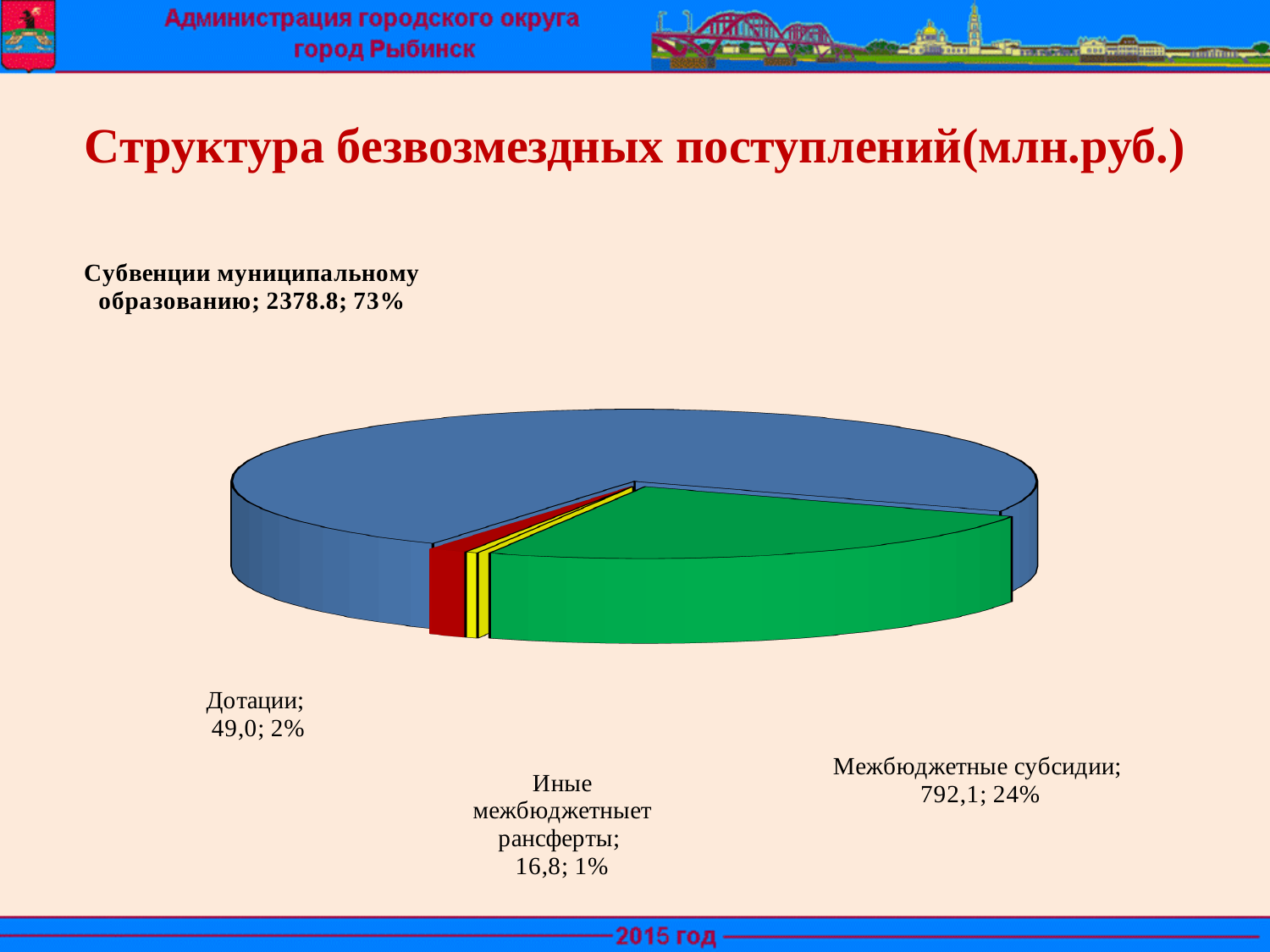
What is the value for Иные межбюджетные трансферты? 16,8 Which category has the smallest slice of the pie? Иные межбюджетные трансферты What is the value for Дотации? 49,0 What kind of chart is shown on the slide? pie chart What is the value for Субвенции муниципальному образованию? 2378.8 Which is larger, the value for Дотации or the value for Иные межбюджетные трансферты? Дотации Which category has the largest slice of the pie? Субвенции муниципальному образованию How many slices does the pie chart have? 4 What is the value for Межбюджетные субсидии? 792,1 What share of the pie does Субвенции муниципальному образованию represent? 73% What share of the pie does Межбюджетные субсидии represent? 24% What is the difference between the values for Межбюджетные субсидии and Дотации? 743,1